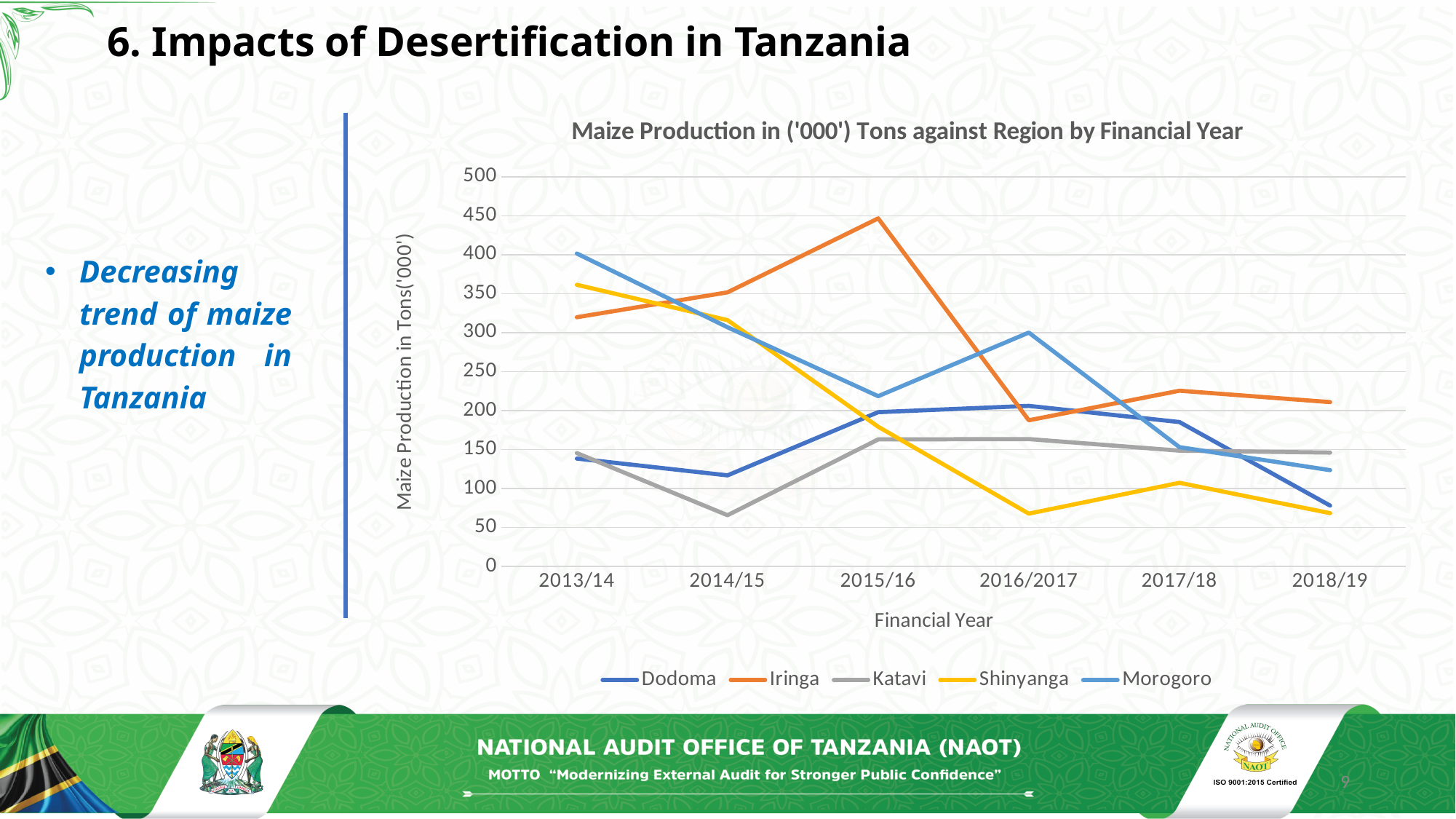
How many financial years are shown on the x axis? 6 What kind of chart is shown on the slide? line chart What is the title of the chart? Maize Production in ('000') Tons against Region by Financial Year Is the value for Shinyanga in 2018/19 greater or less than 100? less How many regions (series) does the legend list? 5 Which region had the highest maize production in 2015/16? Iringa Which region had the lowest maize production in 2014/15? Katavi Does Shinyanga's maize production rise or fall overall from 2013/14 to 2018/19? fall Which region had the highest maize production in 2013/14? Morogoro Is the value for Iringa in 2015/16 greater or less than 400? greater In 2017/18, which region had higher maize production, Iringa or Dodoma? Iringa Which region had the lowest maize production in 2016/2017? Shinyanga